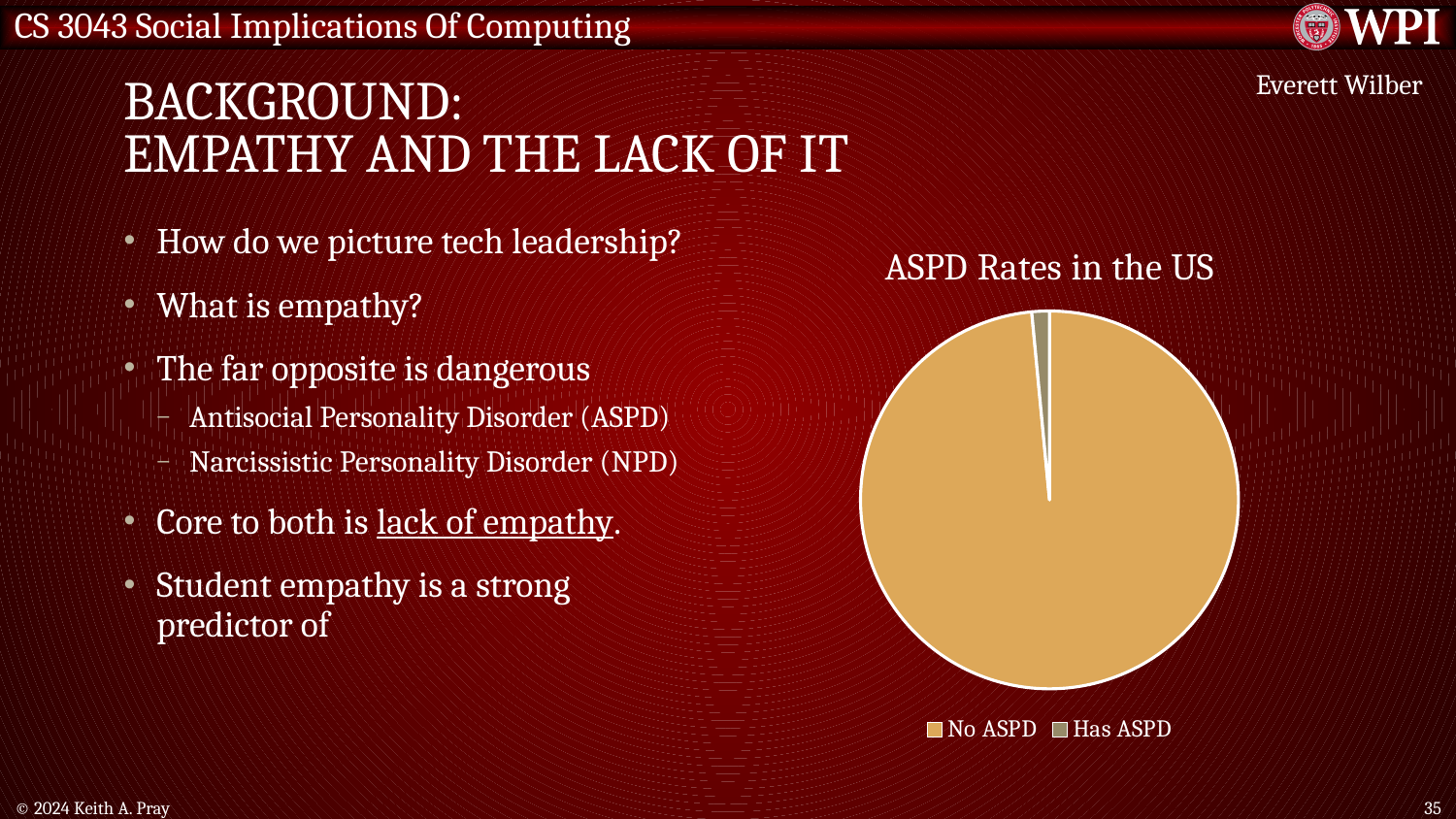
How many entries does the chart's legend list? 2 What is the title of the chart on the slide? ASPD Rates in the US What kind of chart is shown on the slide? pie chart Which category has the largest slice of the pie chart? No ASPD Which slice is larger, No ASPD or Has ASPD? No ASPD Which category has the smallest slice of the pie chart? Has ASPD How many slices does the pie chart have? 2 What colour is the No ASPD slice in the pie chart? tan Does the Has ASPD slice take up more or less than half of the pie? less